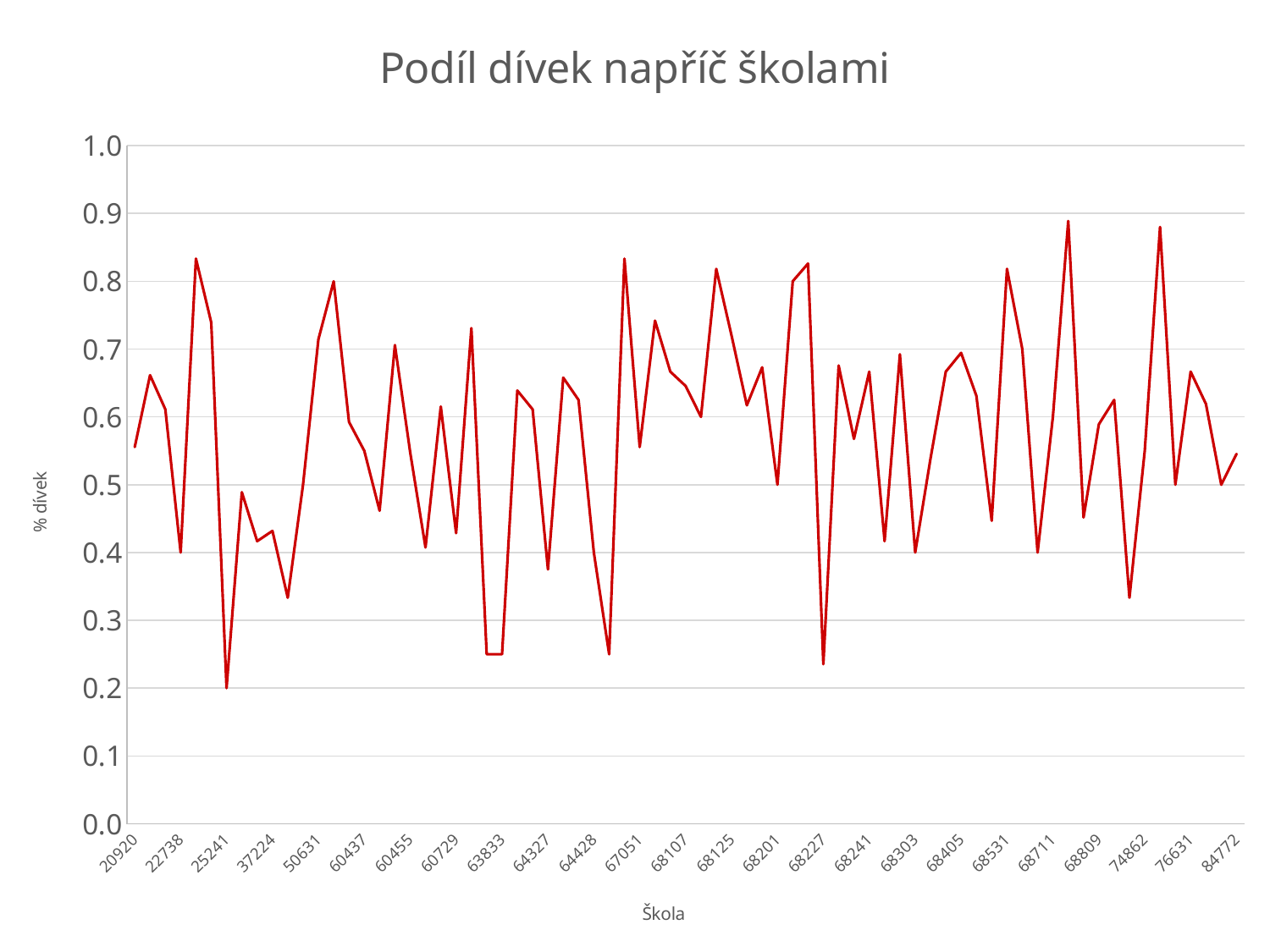
Is the value for school 84772 greater or less than 0.6? less What kind of chart is shown on the slide? line chart Is the value for school 20920 greater or less than 0.6? less Does any value on the chart exceed 0.9? no What is the label of the vertical axis? % dívek Do the values show a steady rise or fall along the x axis, or do they fluctuate? fluctuate What is the title of the chart? Podíl dívek napříč školami